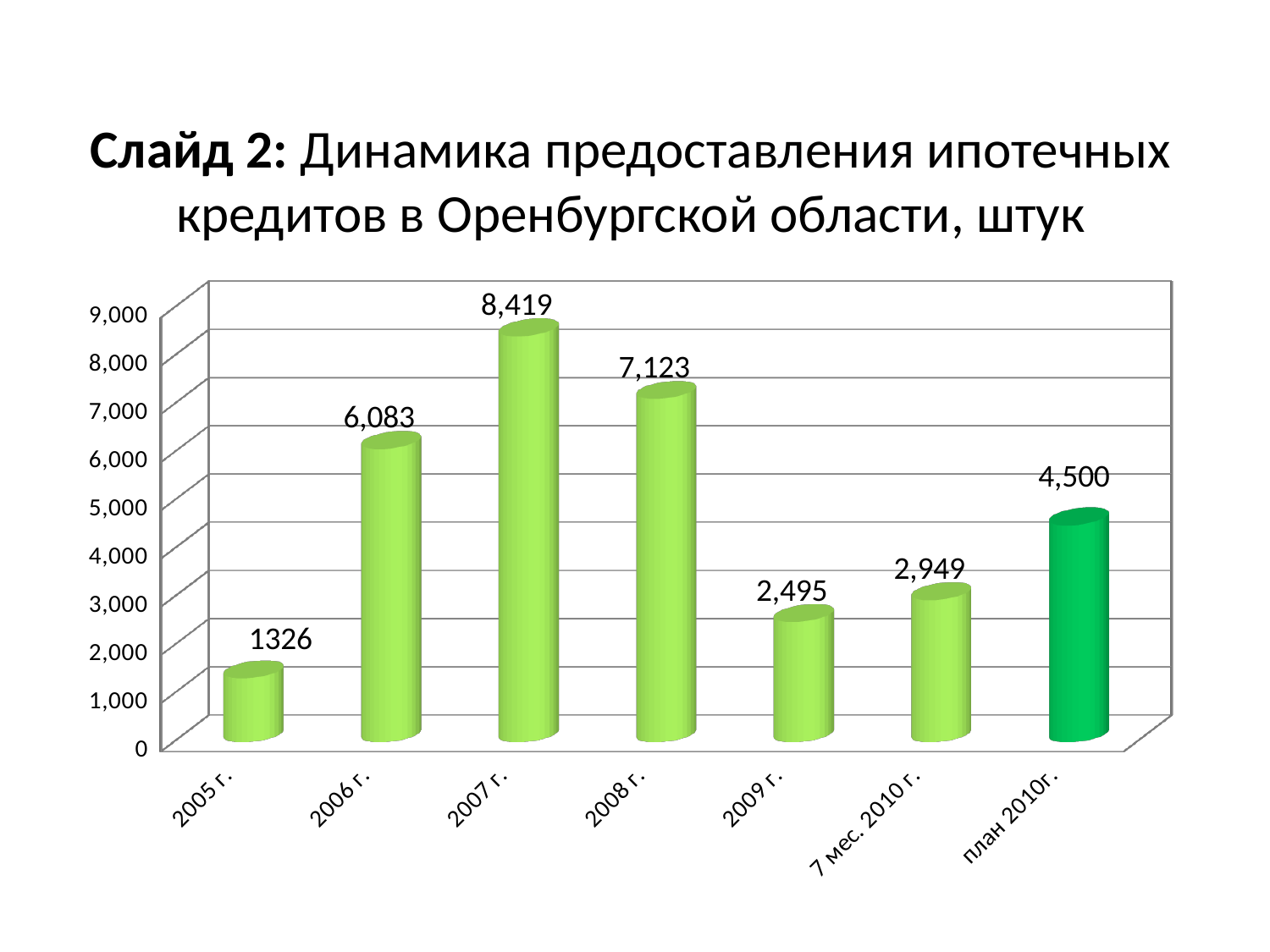
Which category has the highest value? 2007 г. What is the value for 7 мес. 2010 г.? 2,949 What is the value for план 2010г.? 4,500 Which category has the lowest value? 2005 г. How many categories are shown on the x axis? 7 What is the value for 2007 г.? 8,419 What is the value for 2005 г.? 1326 Which bar is shown in a darker green colour than the others? план 2010г. What is the difference between the values for план 2010г. and 7 мес. 2010 г.? 1,551 What kind of chart is shown on the slide? bar chart What is the difference between the values for 2007 г. and 2008 г.? 1,296 Which is larger, the value for 2006 г. or the value for 2008 г.? 2008 г.